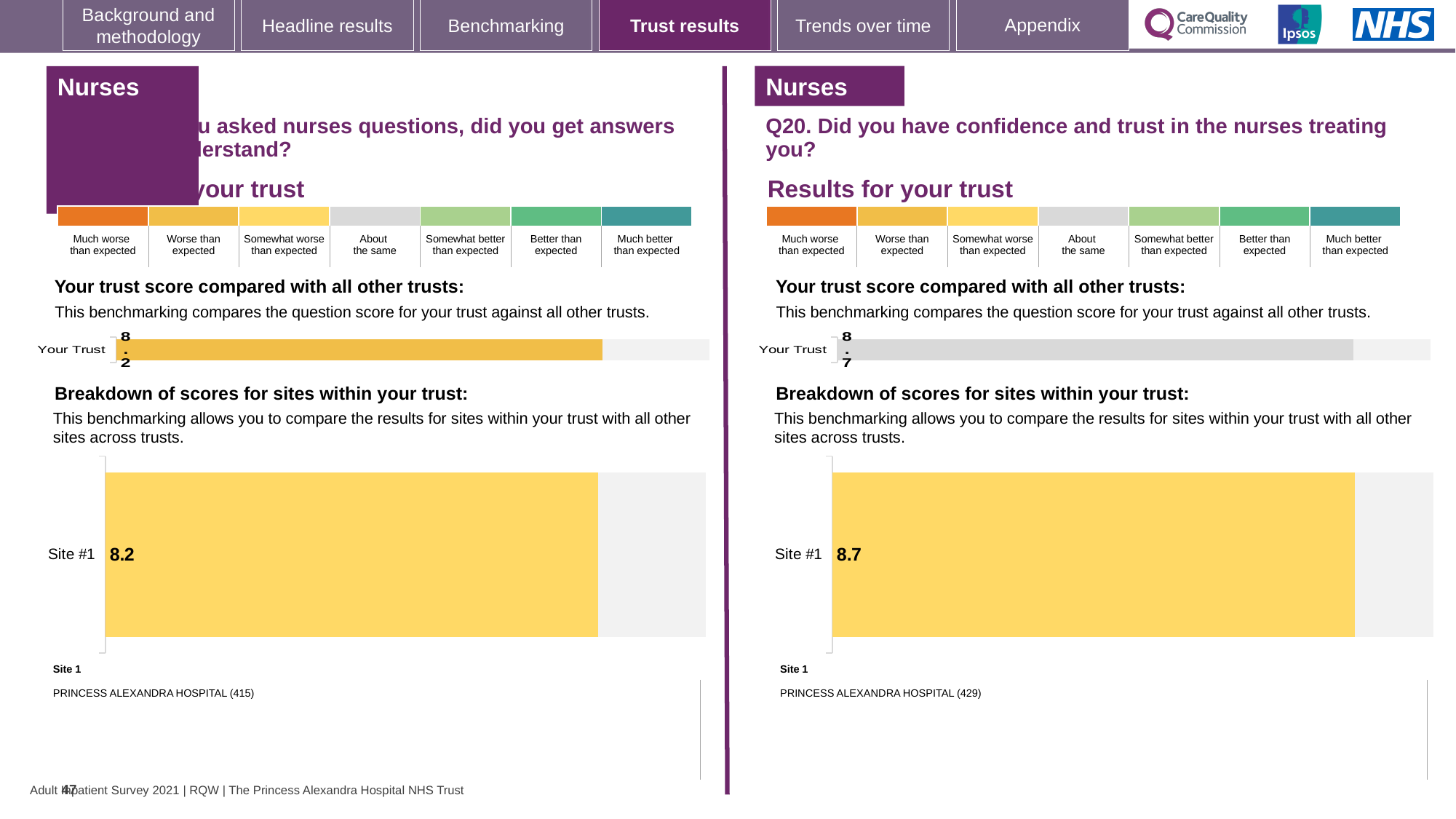
On the left-hand site breakdown chart, what is the score for Site #1? 8.2 On the left-hand chart, what is the score shown for Your Trust? 8.2 Which is larger: the Your Trust score on the left-hand chart or the Your Trust score on the right-hand chart (Q20)? Right-hand chart (Q20) Which site is listed as Site 1 on the right-hand side (Q20)? PRINCESS ALEXANDRA HOSPITAL (429) What is the difference between the Site #1 score on the right-hand chart (Q20) and the Site #1 score on the left-hand chart? 0.5 What colour is the Your Trust bar on the right-hand chart for Q20? Grey On the right-hand site breakdown chart for Q20, what is the score for Site #1? 8.7 On the right-hand chart for Q20, what is the score shown for Your Trust? 8.7 How many sites are shown in the site breakdown chart on the left-hand side? 1 What kind of chart is used to show the Site #1 score on the right-hand side? Bar chart How many sites are shown in the site breakdown chart on the right-hand side (Q20)? 1